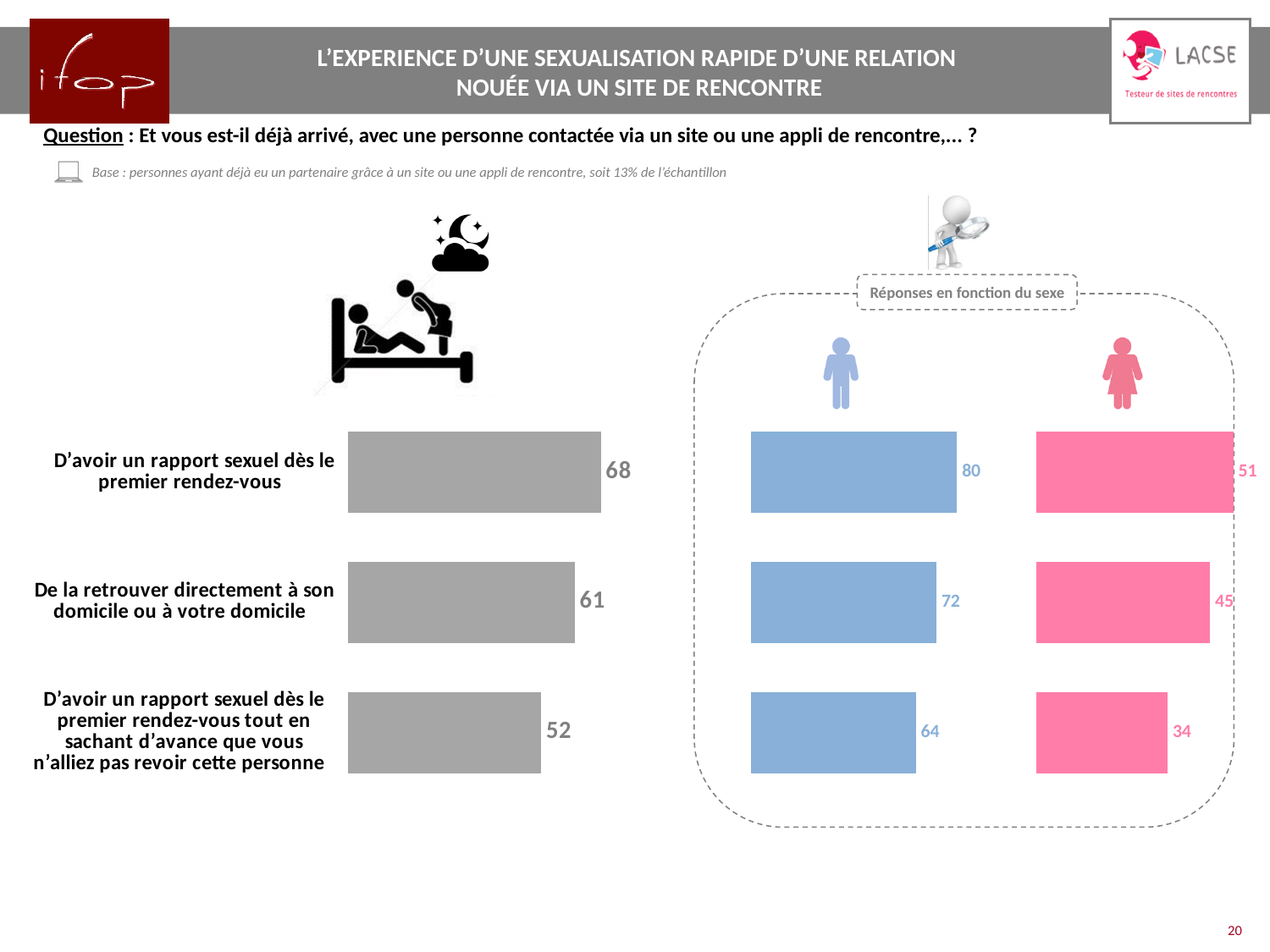
In the grey bar chart on the left, what is the difference between the highest and lowest values? 16 For "De la retrouver directement à son domicile ou à votre domicile", which is larger: the men's value (blue) or the women's value (pink)? Men (72) What is the difference between the men's value (blue) and the women's value (pink) for "D'avoir un rapport sexuel dès le premier rendez-vous"? 29 In the pink bar chart for women (Réponses en fonction du sexe), what is the value for "De la retrouver directement à son domicile ou à votre domicile"? 45 What type of chart is used to show the overall results on the left of the slide? Bar chart In the pink bar chart for women, what is the value for the third item, about having sex on the first date knowing you would not see the person again? 34 In the grey bar chart on the left, what is the value for "De la retrouver directement à son domicile ou à votre domicile"? 61 In the grey bar chart on the left, what is the value for "D'avoir un rapport sexuel dès le premier rendez-vous"? 68 In the blue bar chart for men, which category has the highest value? D'avoir un rapport sexuel dès le premier rendez-vous In the grey bar chart on the left, which category has the lowest value? D'avoir un rapport sexuel dès le premier rendez-vous tout en sachant d'avance que vous n'alliez pas revoir cette personne How many categories are shown in the grey bar chart on the left? 3 In the blue bar chart for men (Réponses en fonction du sexe), what is the value for "D'avoir un rapport sexuel dès le premier rendez-vous"? 80